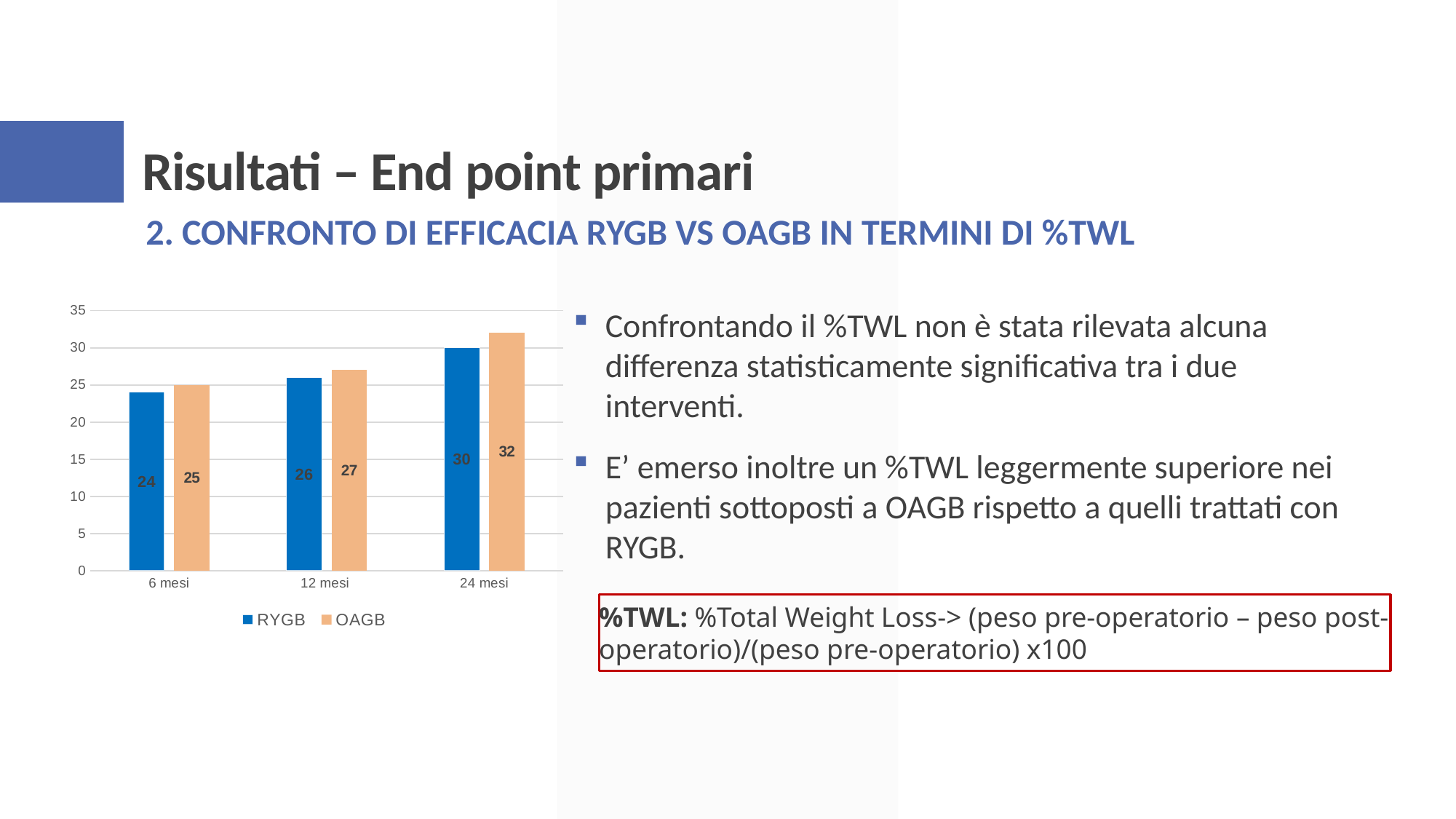
What is the RYGB value at 6 mesi? 24 What is the OAGB value at 12 mesi? 27 How many time points are shown on the x axis? 3 Is the RYGB value at 24 mesi greater or less than 25? greater What kind of chart is shown on the slide? bar chart What is the difference between the OAGB and RYGB values at 24 mesi? 2 How many series does the legend list? 2 What is the OAGB value at 24 mesi? 32 At which time point is the RYGB value highest? 24 mesi At which time point is the OAGB value lowest? 6 mesi Do the RYGB values rise or fall from 6 mesi to 24 mesi? rise Which series has the larger value at 12 mesi, RYGB or OAGB? OAGB